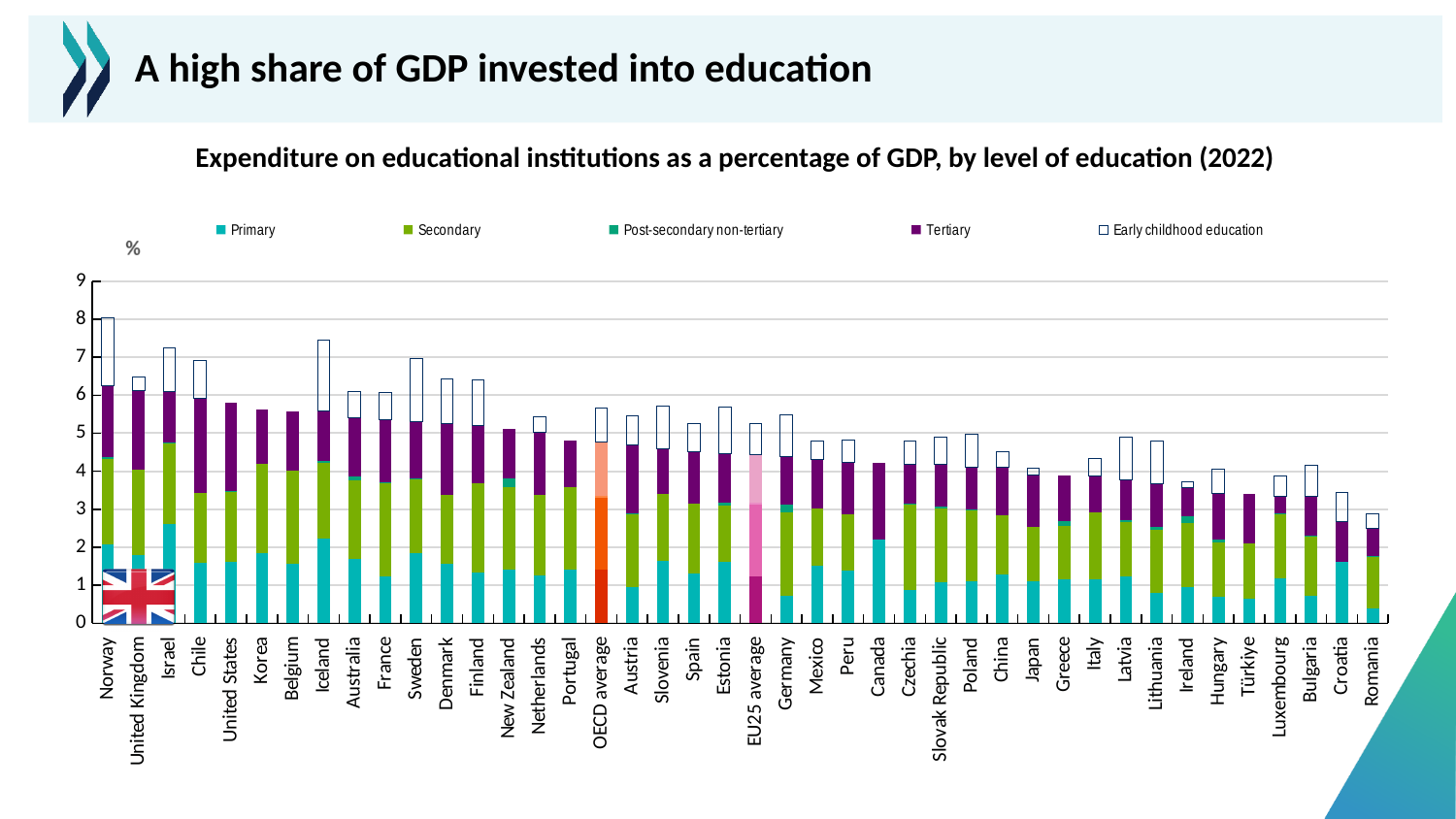
Is the total value for Türkiye greater or less than 4? less What kind of chart is shown on the slide? Stacked bar chart How many series does the legend list? 5 How many countries or averages are shown along the x axis? 42 Which country has the lowest total expenditure on educational institutions as a percentage of GDP? Romania Which legend entry is shown with a purple colour? Tertiary Is the total value for Romania greater or less than 3? less Do the total bar heights generally rise or fall moving from left to right along the x axis? Fall Is the total value for Norway greater or less than 7? greater What is the title of the chart? Expenditure on educational institutions as a percentage of GDP, by level of education (2022) Which has a larger total expenditure as a percentage of GDP, Chile or Korea? Chile Which country has the highest total expenditure on educational institutions as a percentage of GDP? Norway